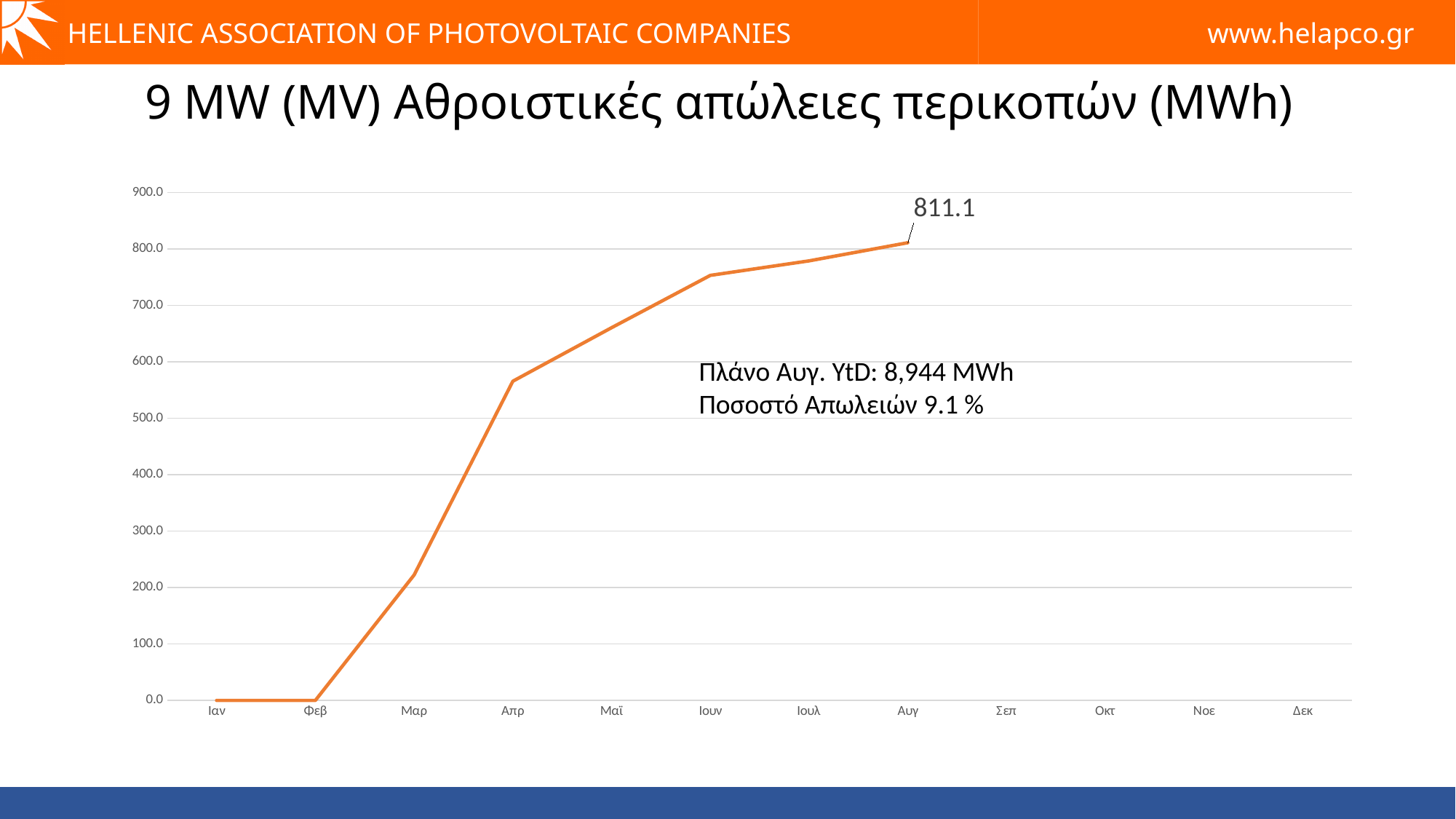
What is the cumulative loss value shown for Αυγ? 811.1 Do the values rise or fall from Ιαν to Αυγ? rise Which is larger, the value for Μαρ or the value for Απρ? Απρ Is the value for Απρ greater or less than 500? greater Is the value for Μαρ greater or less than 300? less Which month has the highest plotted value? Αυγ What is the title of the chart? 9 MW (MV) Αθροιστικές απώλειες περικοπών (MWh) What is the Πλάνο Αυγ. YtD value stated on the chart? 8,944 MWh What kind of chart is shown on the slide? line chart How many months are listed on the x axis? 12 What is the plotted value for Ιαν? 0.0 Is the value for Ιουν greater or less than 700? greater